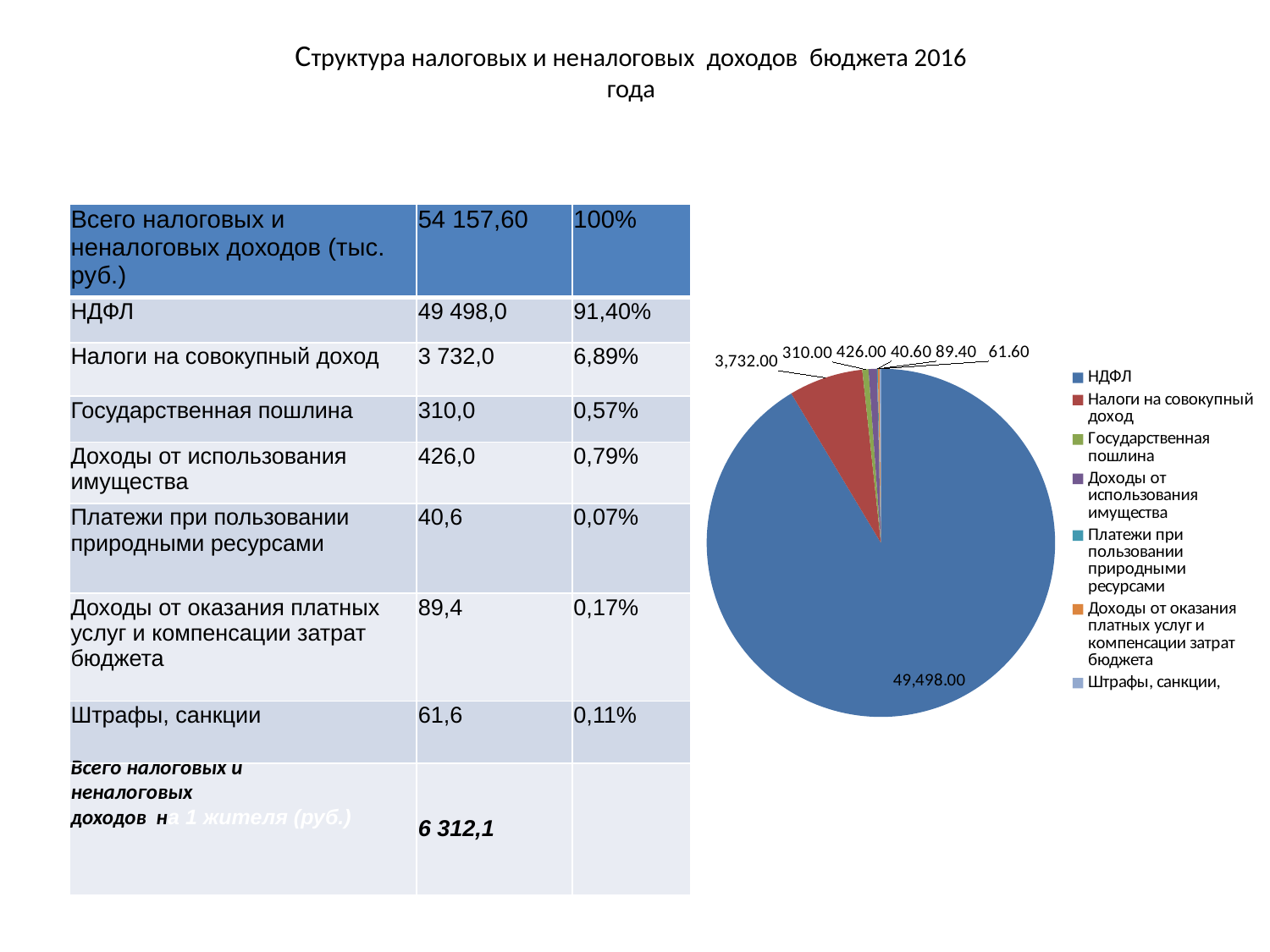
How many slices does the pie chart have? 7 What value is shown for НДФЛ in the pie chart? 49,498.00 What value is shown for Налоги на совокупный доход in the pie chart? 3,732.00 What kind of chart is shown on the slide? pie chart What colour is the НДФЛ slice in the pie chart? blue What is the difference between the values for Налоги на совокупный доход and Государственная пошлина in the pie chart? 3,422.00 What value is shown for Государственная пошлина in the pie chart? 310.00 How many entries does the pie chart's legend list? 7 In the pie chart, which is larger: Доходы от использования имущества or Государственная пошлина? Доходы от использования имущества Which category has the largest slice in the pie chart? НДФЛ What value is shown for Штрафы, санкции in the pie chart? 61.60 Which category has the smallest slice in the pie chart? Платежи при пользовании природными ресурсами